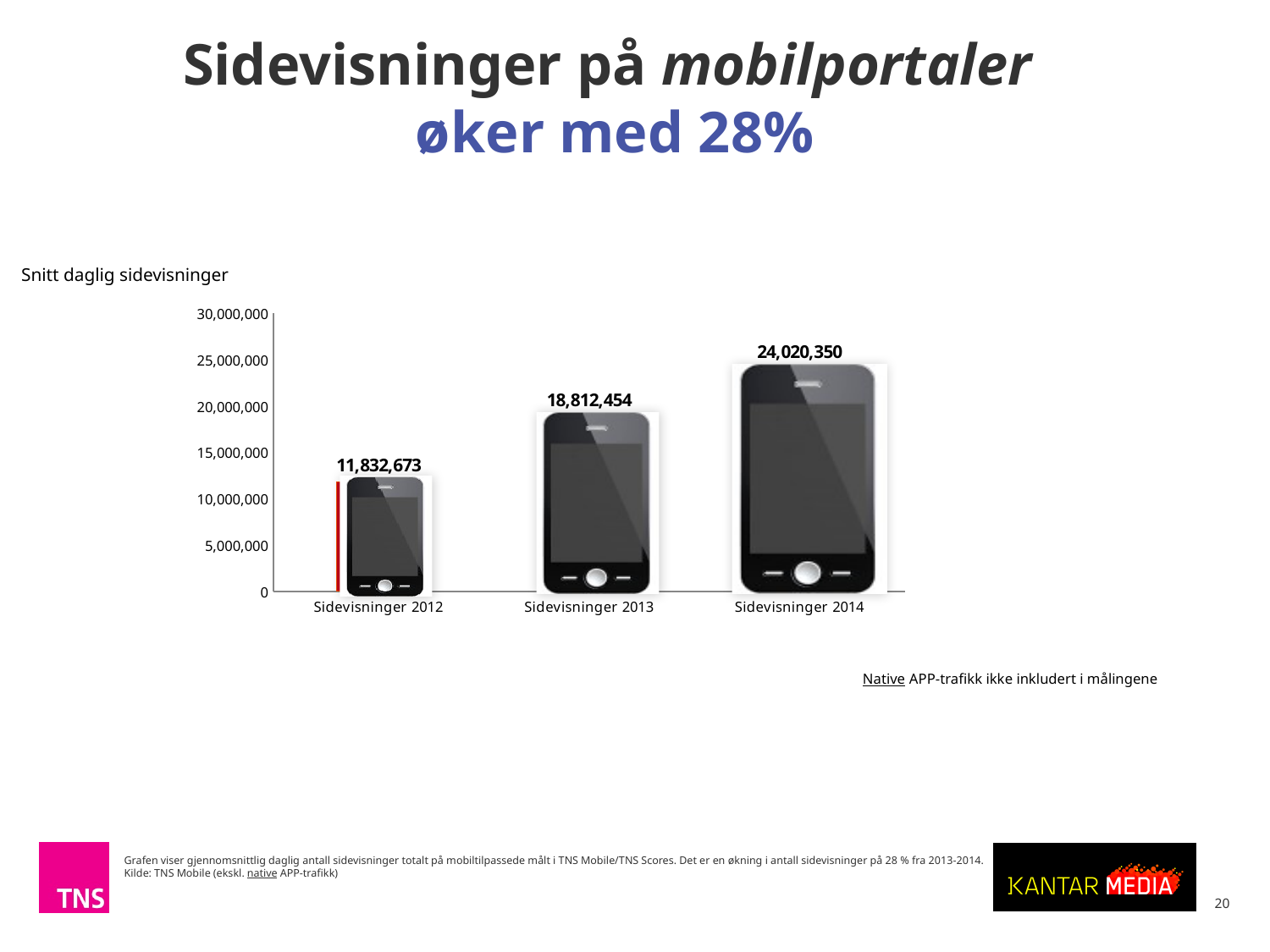
What is the difference between the values for Sidevisninger 2014 and Sidevisninger 2013? 5,207,896 What is the value for Sidevisninger 2012? 11,832,673 How many categories are shown on the x axis? 3 Which category has the lowest value? Sidevisninger 2012 What is the value for Sidevisninger 2013? 18,812,454 What kind of chart is shown on the slide? bar chart Is the value for Sidevisninger 2012 greater or less than 15,000,000? less Do the values rise or fall from 2012 to 2014? rise Which category has the highest value? Sidevisninger 2014 What is the difference between the values for Sidevisninger 2013 and Sidevisninger 2012? 6,979,781 Which is larger, the value for Sidevisninger 2012 or Sidevisninger 2013? Sidevisninger 2013 What is the value for Sidevisninger 2014? 24,020,350